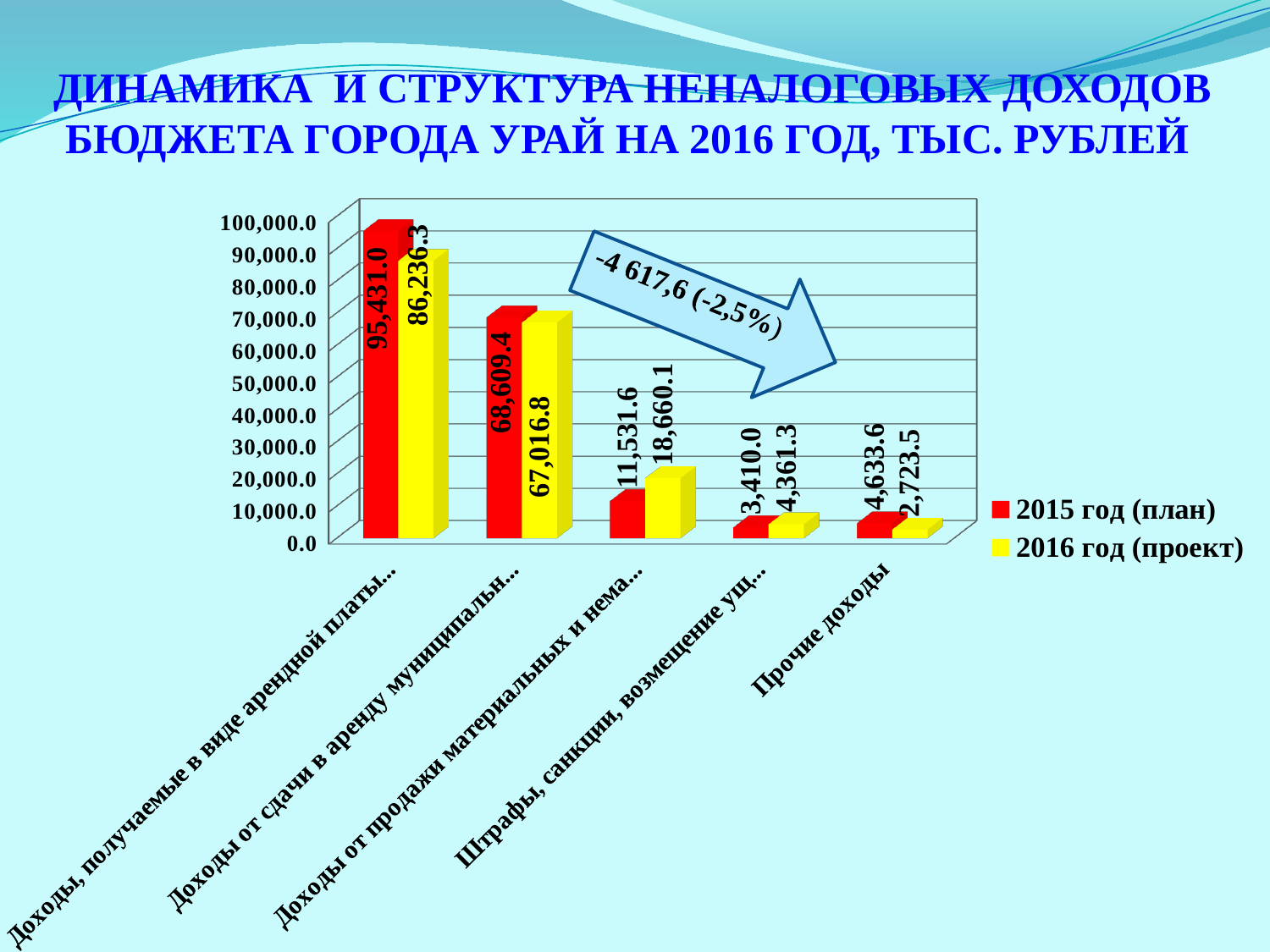
Which category has the highest 2015 год (план) value? Доходы, получаемые в виде арендной платы... How many series does the legend list? 2 What is the value for "Прочие доходы" in the 2015 год (план) series? 4,633.6 What is the value for "Прочие доходы" in the 2016 год (проект) series? 2,723.5 Which category has the lowest 2016 год (проект) value? Прочие доходы What is the 2015 год (план) value for the category "Штрафы, санкции, возмещение ущ..."? 3,410.0 How many categories are plotted on the x axis? 5 For the category "Доходы от продажи материальных и нема...", which series has the larger value, 2015 год (план) or 2016 год (проект)? 2016 год (проект) What colour are the bars for the 2016 год (проект) series? yellow What is the 2016 год (проект) value for the first category, "Доходы, получаемые в виде арендной платы..."? 86,236.3 What is the difference between the 2015 год (план) and 2016 год (проект) values for the first category, "Доходы, получаемые в виде арендной платы..."? 9,194.7 What kind of chart is shown on the slide? bar chart